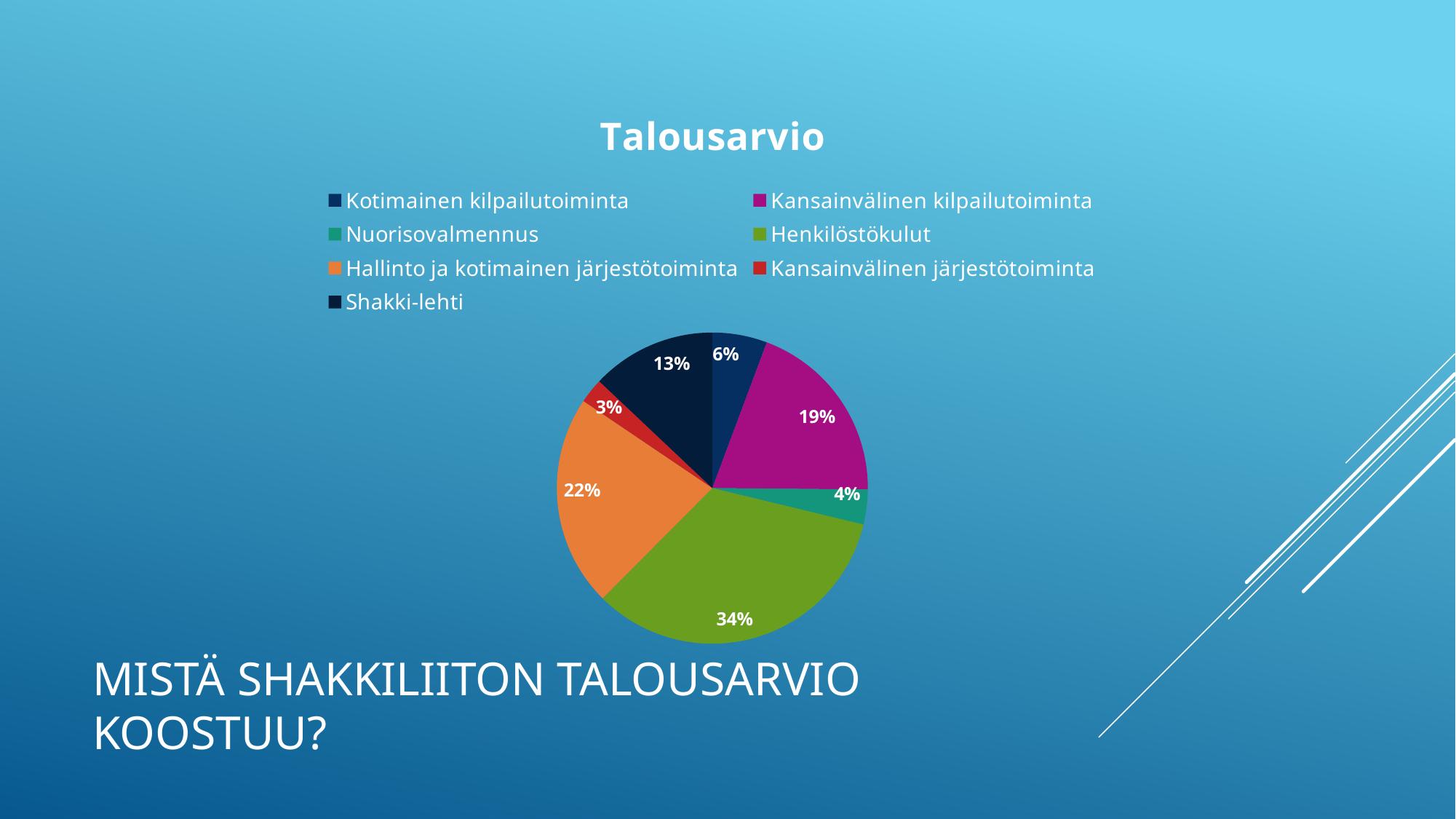
What share of the pie does Kansainvälinen kilpailutoiminta have? 19% What share of the pie does Hallinto ja kotimainen järjestötoiminta have? 22% How many categories does the legend of the pie chart list? 7 What share of the pie does Nuorisovalmennus have? 4% What is the difference in percentage points between Henkilöstökulut and Hallinto ja kotimainen järjestötoiminta? 12 Which category has the smallest share of the pie? Kansainvälinen järjestötoiminta What kind of chart is shown on the slide? pie chart Which has a larger share: Kotimainen kilpailutoiminta or Shakki-lehti? Shakki-lehti What is the title of the chart? Talousarvio Which category has the largest share of the pie? Henkilöstökulut